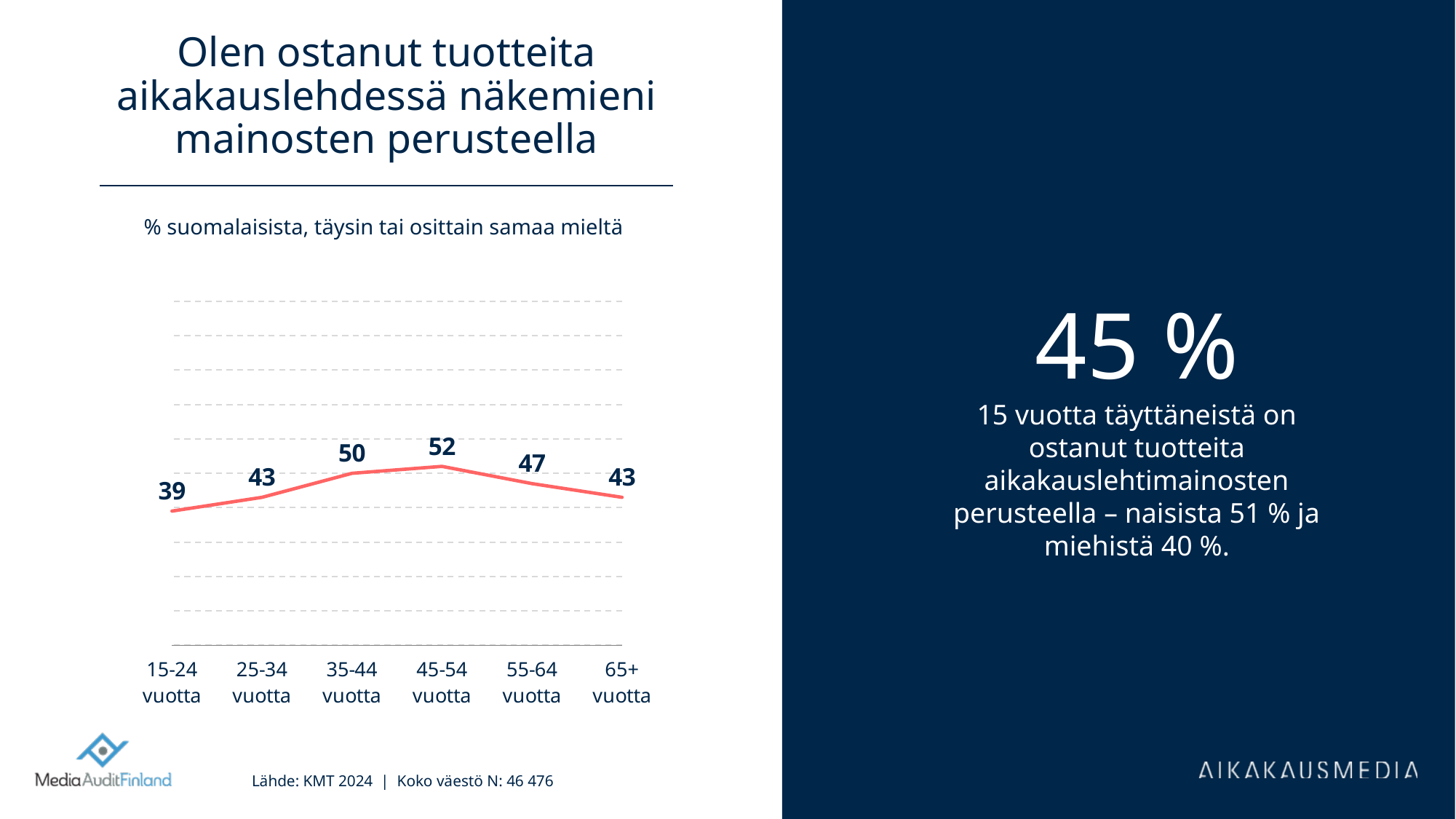
Which age group has the lowest value? 15-24 vuotta What is the title of the chart? Olen ostanut tuotteita aikakauslehdessä näkemieni mainosten perusteella What is the value for the 35-44 vuotta age group? 50 Do the values rise or fall from 15-24 vuotta to 45-54 vuotta? Rise Which is larger, the value for 55-64 vuotta or the value for 25-34 vuotta? 55-64 vuotta Which age group has the highest value? 45-54 vuotta What is the value for the 65+ vuotta age group? 43 What is the difference between the values for 45-54 vuotta and 15-24 vuotta? 13 What kind of chart is shown on the slide? Line chart How many age groups are plotted on the chart? 6 What is the value for the 15-24 vuotta age group? 39 What is the difference between the values for 35-44 vuotta and 55-64 vuotta? 3